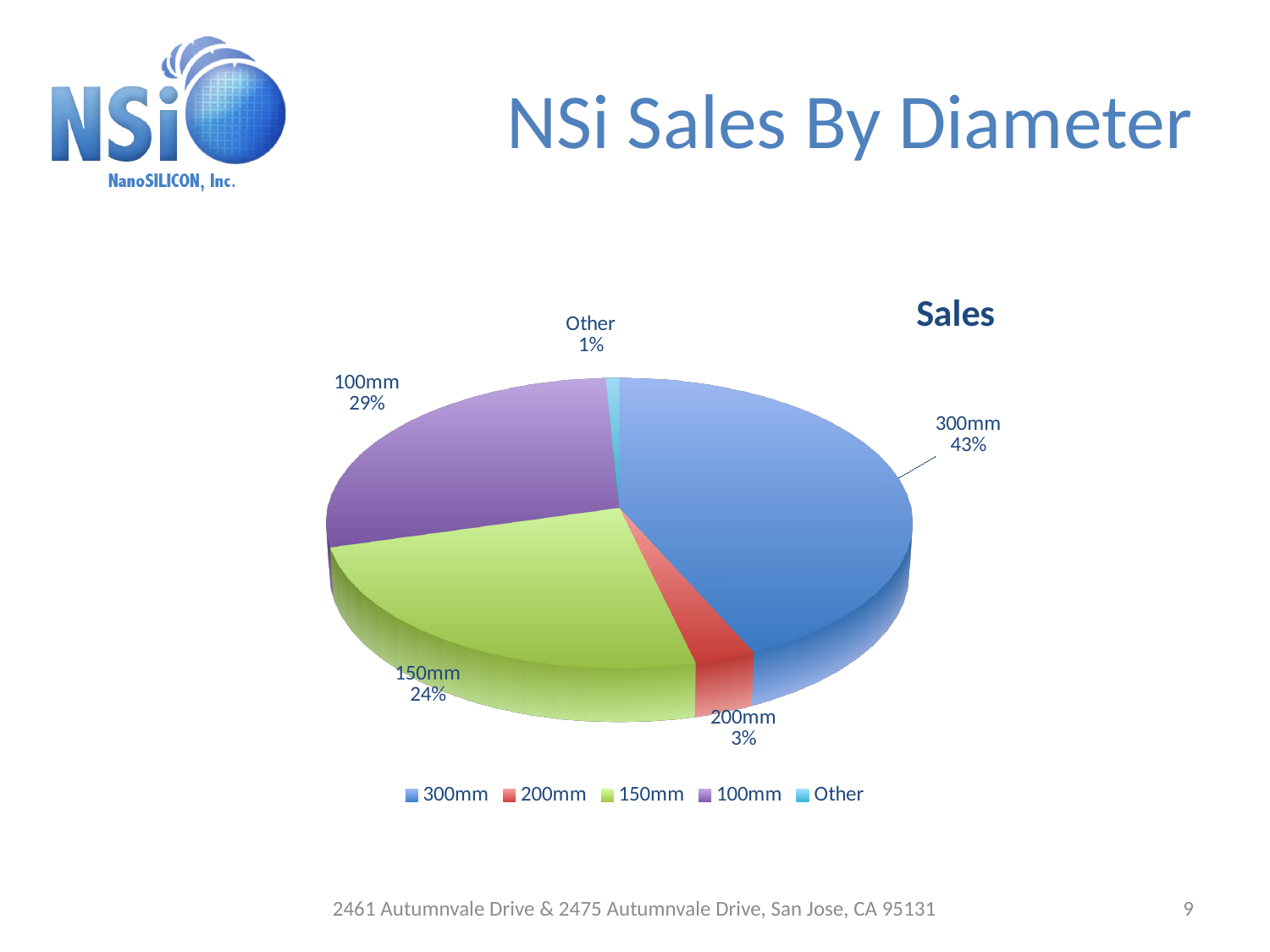
What share of sales does the 150mm slice represent? 24% How many categories are shown in the pie chart? 5 Which has a larger share of sales, 150mm or 100mm? 100mm What share of sales does the 300mm slice represent? 43% What share of sales does the 100mm slice represent? 29% What is the difference in percentage points between the 300mm and 100mm shares? 14 What is the title shown on the chart itself? Sales What kind of chart is shown on the slide? Pie chart Which category has the smallest share of sales? Other Which diameter category has the largest share of sales? 300mm